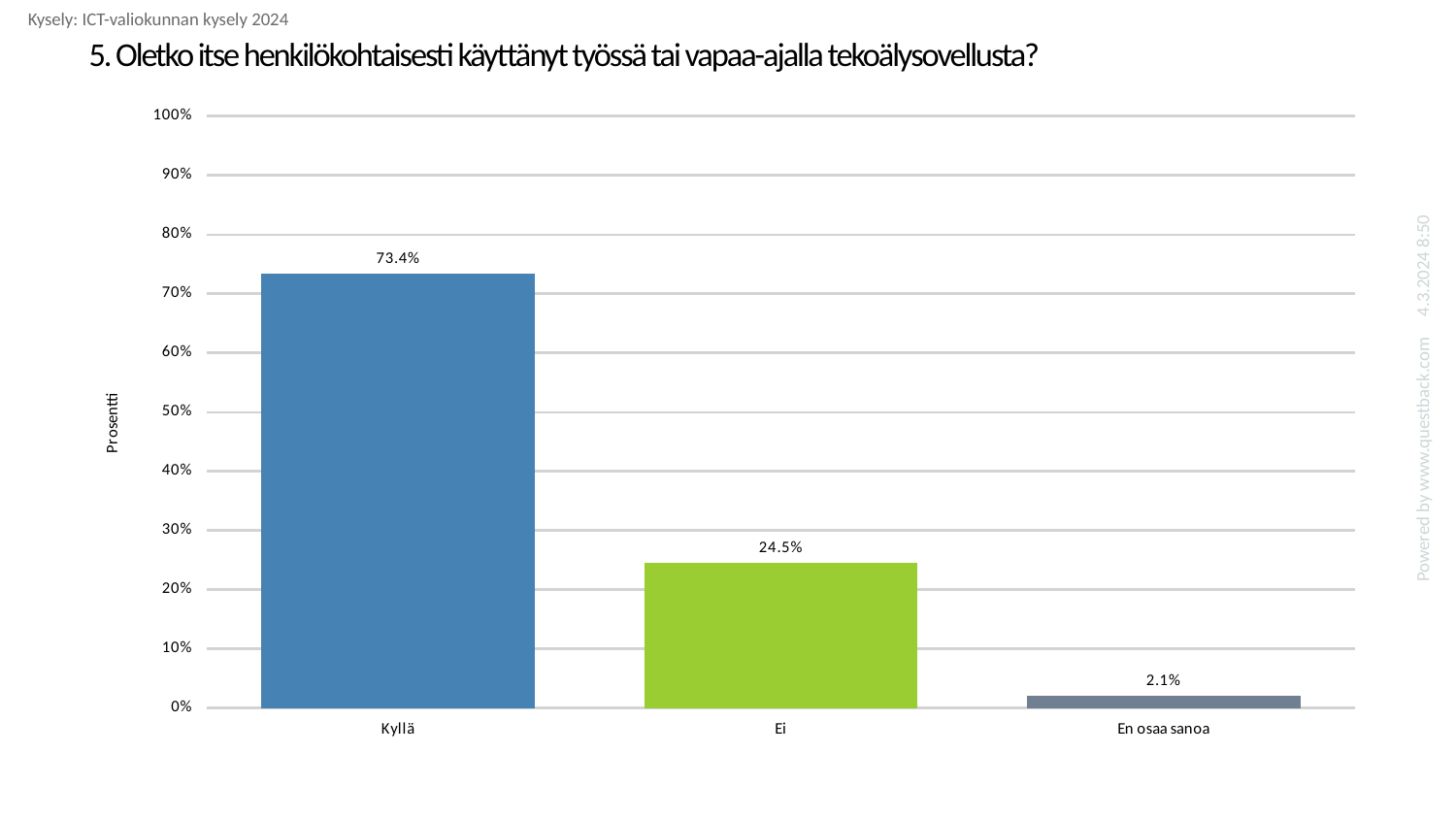
What is the difference between the values for Kyllä and Ei? 48.9% Is the value for Kyllä greater or less than 70%? greater What kind of chart is shown on the slide? bar chart How many categories are shown on the x axis? 3 What is the value for Kyllä? 73.4% What is the difference between the values for Ei and En osaa sanoa? 22.4% What is the value for En osaa sanoa? 2.1% Which category has the lowest value? En osaa sanoa What is the label of the y axis? Prosentti What is the value for Ei? 24.5% Which category has the highest value? Kyllä Which is larger, the value for Ei or the value for En osaa sanoa? Ei